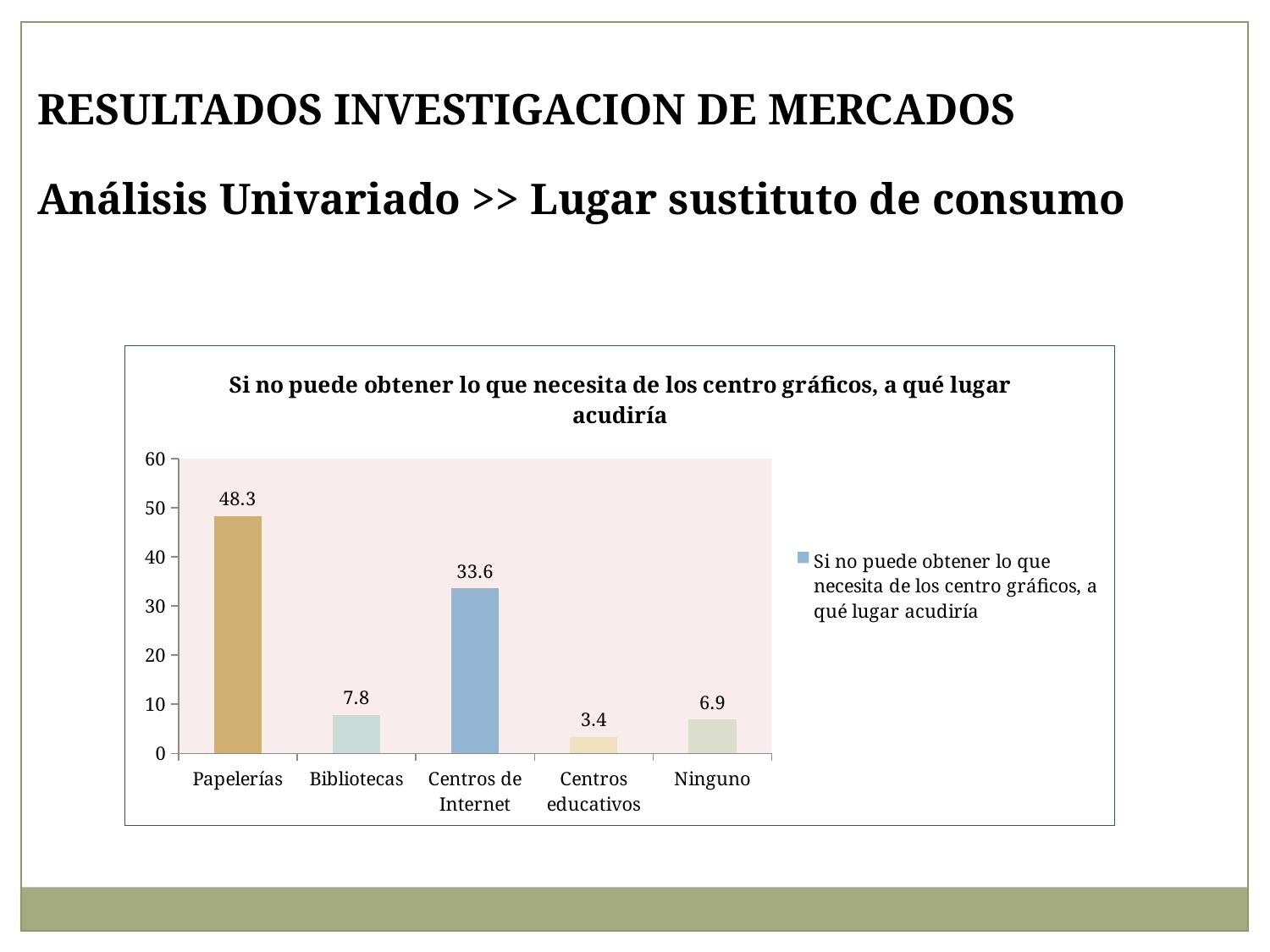
What is the value for Ninguno? 6.9 Which category has the lowest value? Centros educativos What is the value for Centros educativos? 3.4 What kind of chart is shown on the slide? bar chart Which category has the highest value? Papelerías What is the value for Centros de Internet? 33.6 What is the title of the chart? Si no puede obtener lo que necesita de los centro gráficos, a qué lugar acudiría What is the difference between the values for Papelerías and Centros de Internet? 14.7 What is the value for Papelerías? 48.3 How many categories are shown on the x axis? 5 Which is larger, the value for Bibliotecas or the value for Ninguno? Bibliotecas Is the value for Centros de Internet greater or less than 30? greater